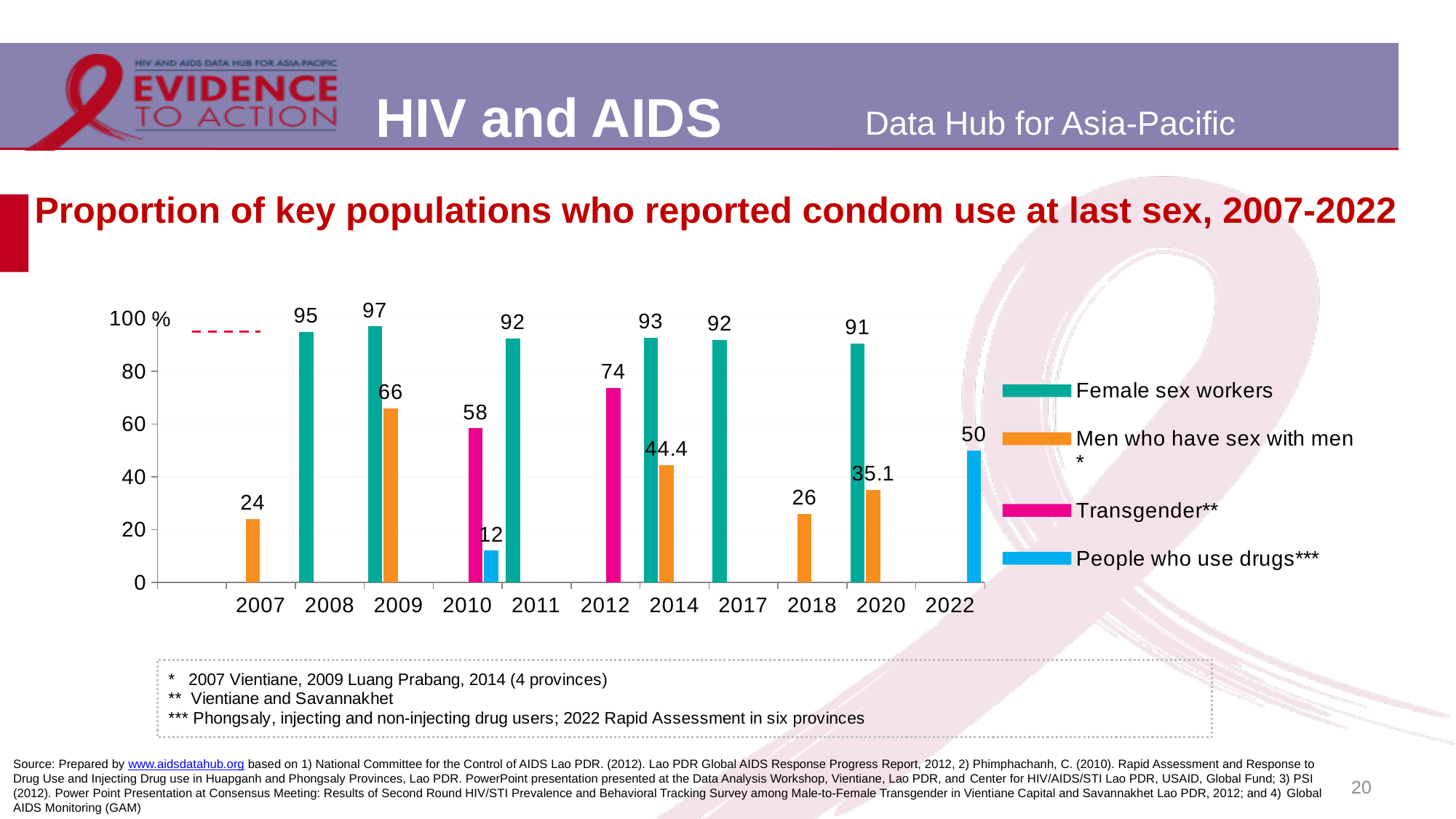
What is the value for People who use drugs in 2022? 50 How many series does the legend list? 4 What is the value for Men who have sex with men in 2014? 44.4 What is the value for Female sex workers in 2009? 97 Which is larger: the Transgender value in 2010 or the Transgender value in 2012? 2012 In which year is the Female sex workers value highest? 2009 In which year is the Men who have sex with men value lowest? 2007 How many years are shown on the x axis? 11 What is the difference between the Female sex workers value and the Men who have sex with men value in 2020? 55.9 Which series is shown in magenta in the legend? Transgender** What is the value for Transgender in 2012? 74 What kind of chart is shown on the slide? bar chart